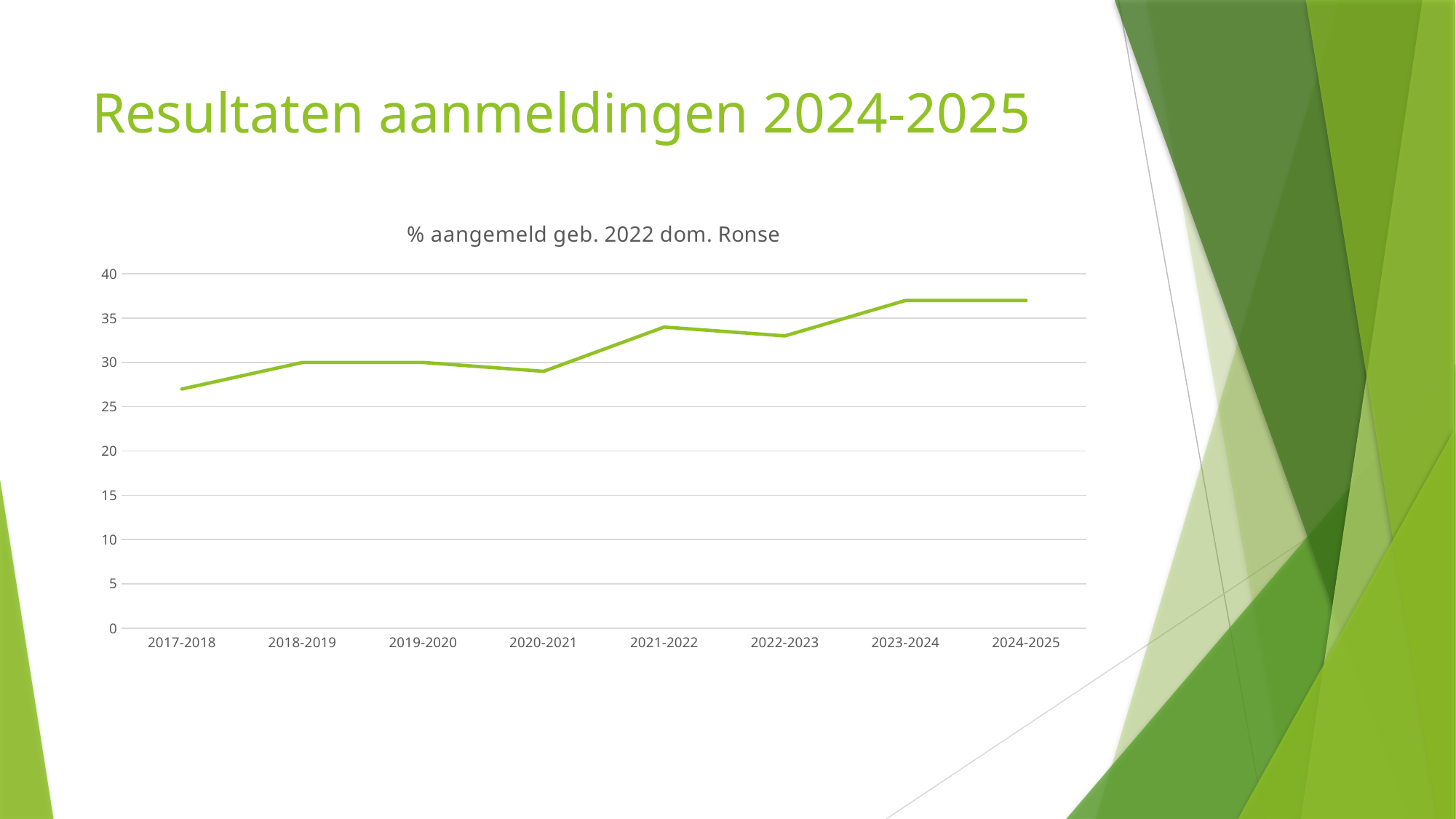
Do the values generally rise or fall from 2017-2018 to 2024-2025? rise What type of chart is shown on the slide? line chart What is the value for 2019-2020? 30 Is the value for 2021-2022 greater or less than 30? greater What is the title of the chart? % aangemeld geb. 2022 dom. Ronse How many school years are plotted on the x axis? 8 Is the value for 2020-2021 greater or less than 30? less Is the value for 2017-2018 greater or less than 30? less Which school year has the lowest value? 2017-2018 Which is larger, the value for 2021-2022 or the value for 2018-2019? 2021-2022 What is the value for 2018-2019? 30